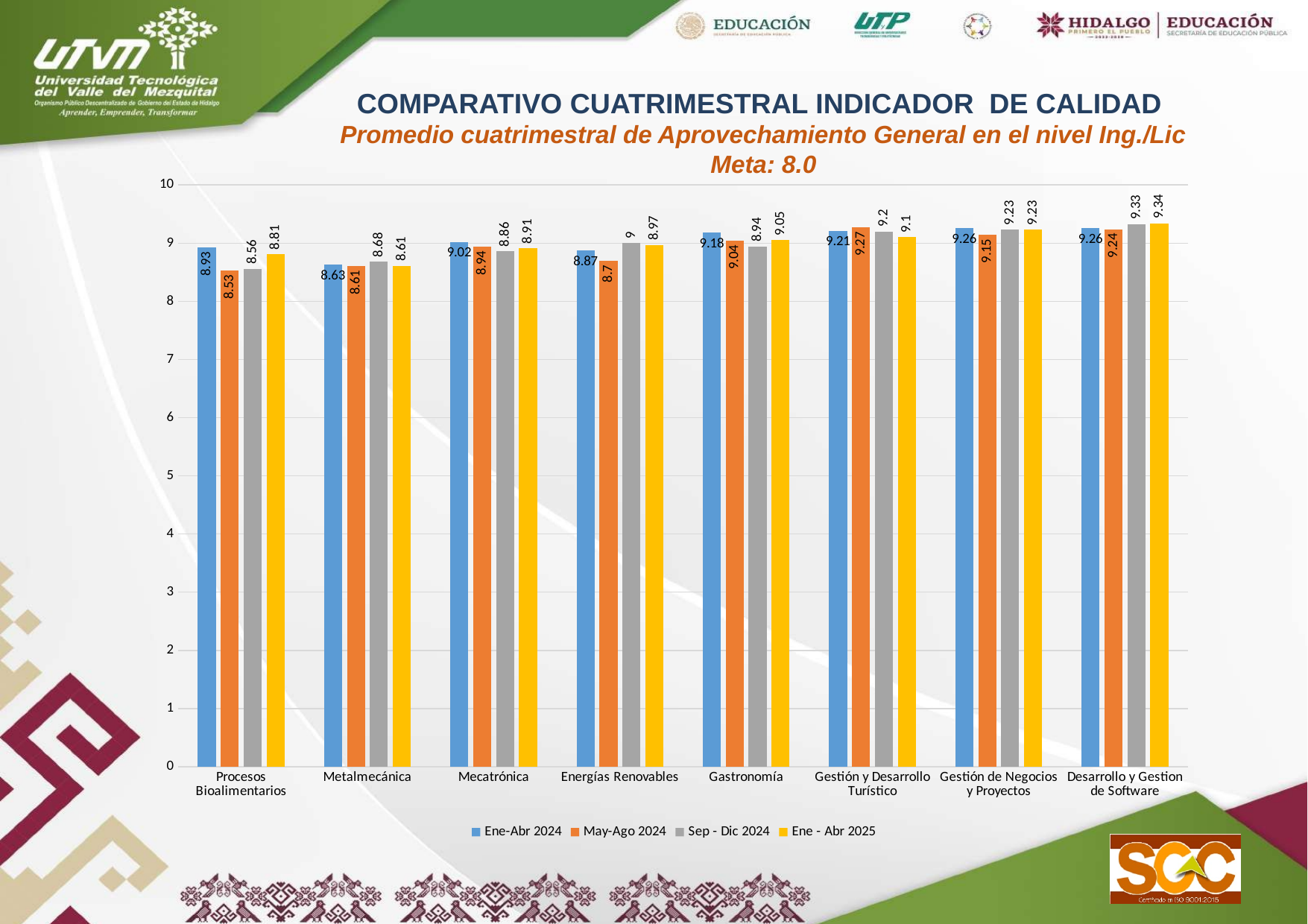
What type of chart is shown on the slide? bar chart What is the value for Energías Renovables in the Sep - Dic 2024 series? 9 How many program categories are shown along the x axis? 8 How many series does the legend list? 4 Which is larger for Gastronomía: the Ene-Abr 2024 value or the Sep - Dic 2024 value? Ene-Abr 2024 What target (Meta) is stated in the chart title? 8.0 What is the difference between the Ene-Abr 2024 and May-Ago 2024 values for Procesos Bioalimentarios? 0.4 Which category has the lowest value in the May-Ago 2024 series? Procesos Bioalimentarios Is the May-Ago 2024 value for Metalmecánica greater or less than 9? less What is the value for Gestión y Desarrollo Turístico in the May-Ago 2024 series? 9.27 Which category has the highest value in the Ene - Abr 2025 series? Desarrollo y Gestion de Software What is the value for Mecatrónica in the Ene-Abr 2024 series? 9.02